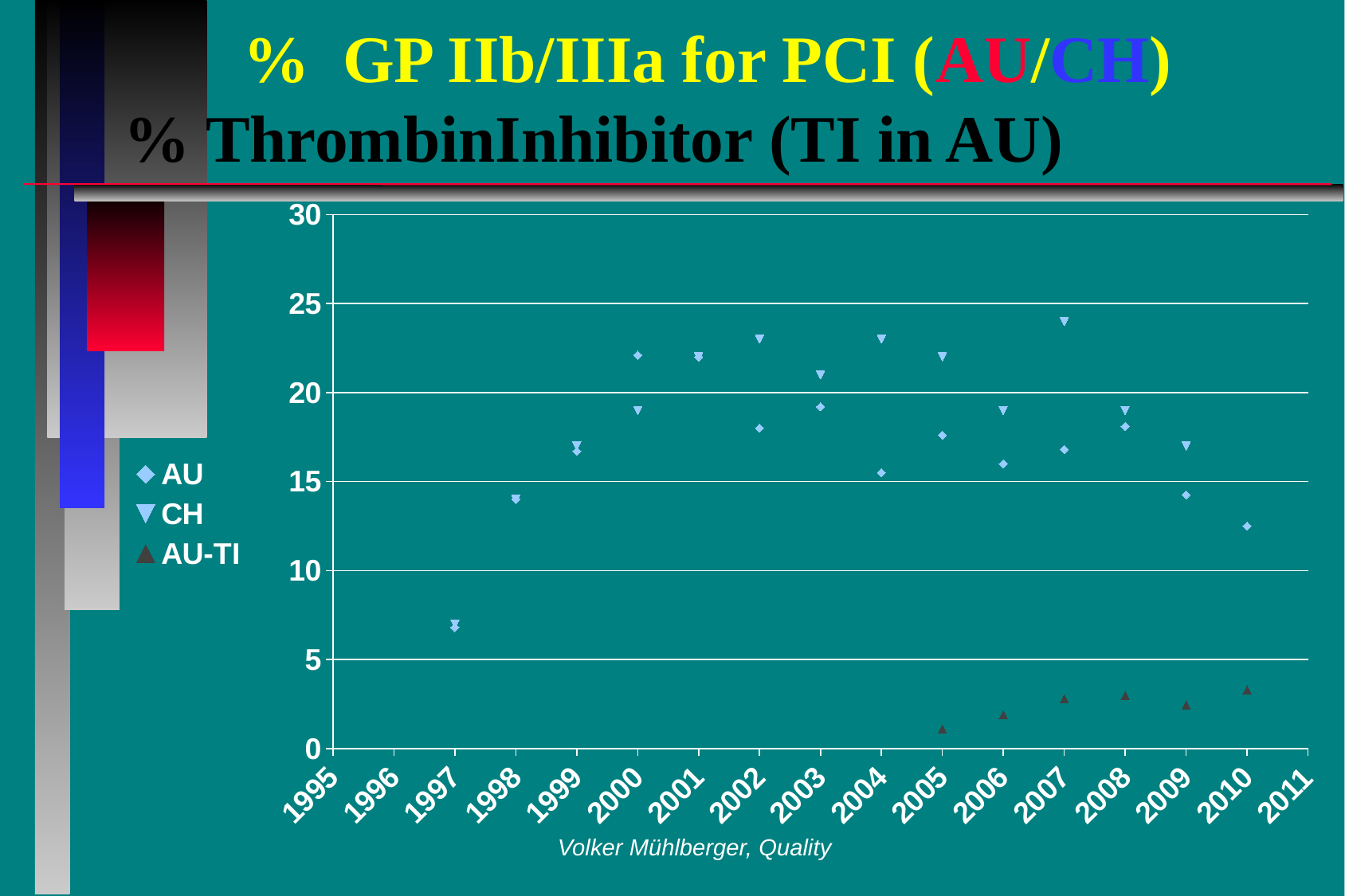
In 2004, which series has the larger value, AU or CH? CH Is the AU-TI value for 2005 greater or less than 5? less Is the AU value for 2010 greater or less than 15? less Is the CH value for 2002 greater or less than 20? greater What kind of chart is shown on the slide? scatter chart In 2007, which series has the larger value, AU or CH? CH How many data points are plotted for the AU-TI series? 6 Which series are listed in the legend? AU, CH, AU-TI Do the AU values rise or fall from 2008 to 2010? fall How many series does the legend list? 3 In which year is the AU value lowest? 1997